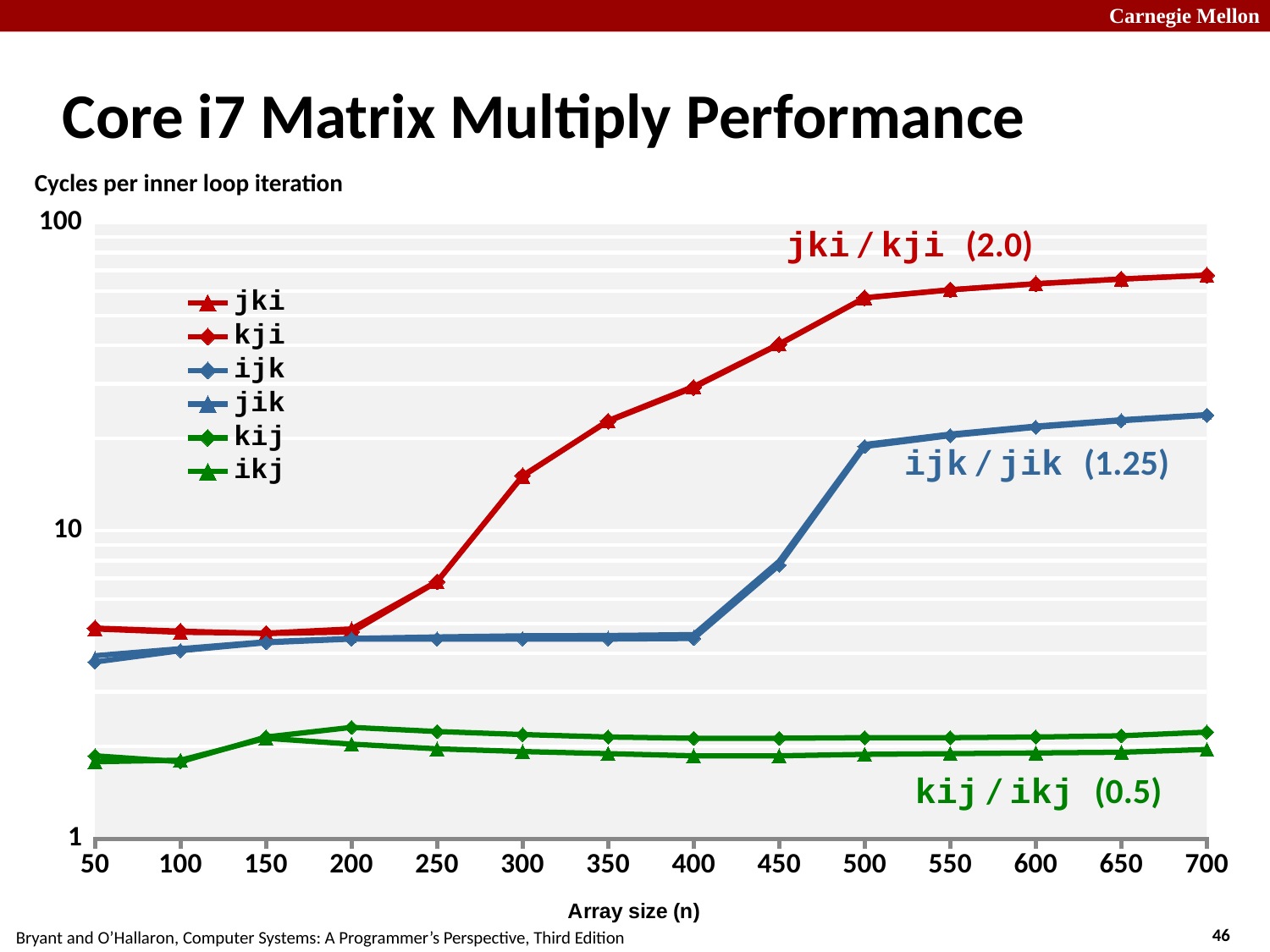
At array size 400, which is larger: the value for ijk or the value for kij? ijk How many series does the legend list? 6 How many array sizes are plotted along the x axis? 14 What is the label of the x axis? Array size (n) Does the jki series rise or fall as array size increases from 200 to 500? rises Is the value for ijk at array size 200 greater or less than 10? less What kind of chart is shown on the slide? line chart Is the value for jki at array size 700 greater or less than 10? greater At array size 700, which is larger: the value for jki or the value for ikj? jki Is the value for kij at array size 700 greater or less than 10? less What is the title of the chart? Core i7 Matrix Multiply Performance